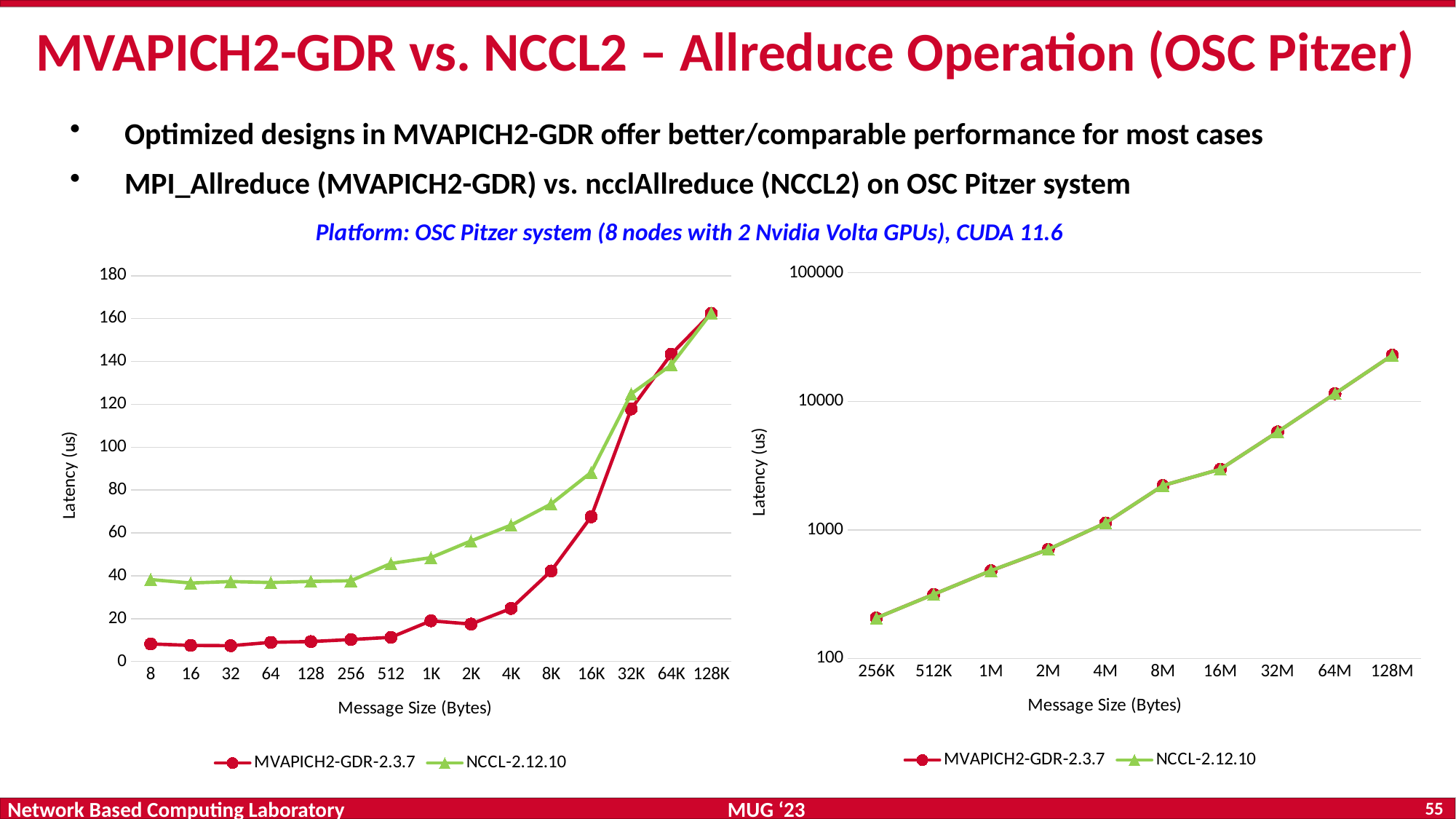
How many message sizes are plotted on the x axis of the right chart? 10 In the right chart, is the latency for MVAPICH2-GDR-2.3.7 at 128M greater or less than 10000? greater In the left chart, is the latency for MVAPICH2-GDR-2.3.7 at 8 bytes greater or less than 20? less What is the y-axis title of the left chart? Latency (us) How many message sizes are plotted on the x axis of the left chart? 15 In the left chart, is the latency for NCCL-2.12.10 at 16K greater or less than 80? greater In the right chart, do the latency values rise or fall as message size increases? rise How many series does the legend of the left chart list? 2 What kind of chart is the left chart on the slide? line chart In the left chart, which series has the higher latency at 4K, MVAPICH2-GDR-2.3.7 or NCCL-2.12.10? NCCL-2.12.10